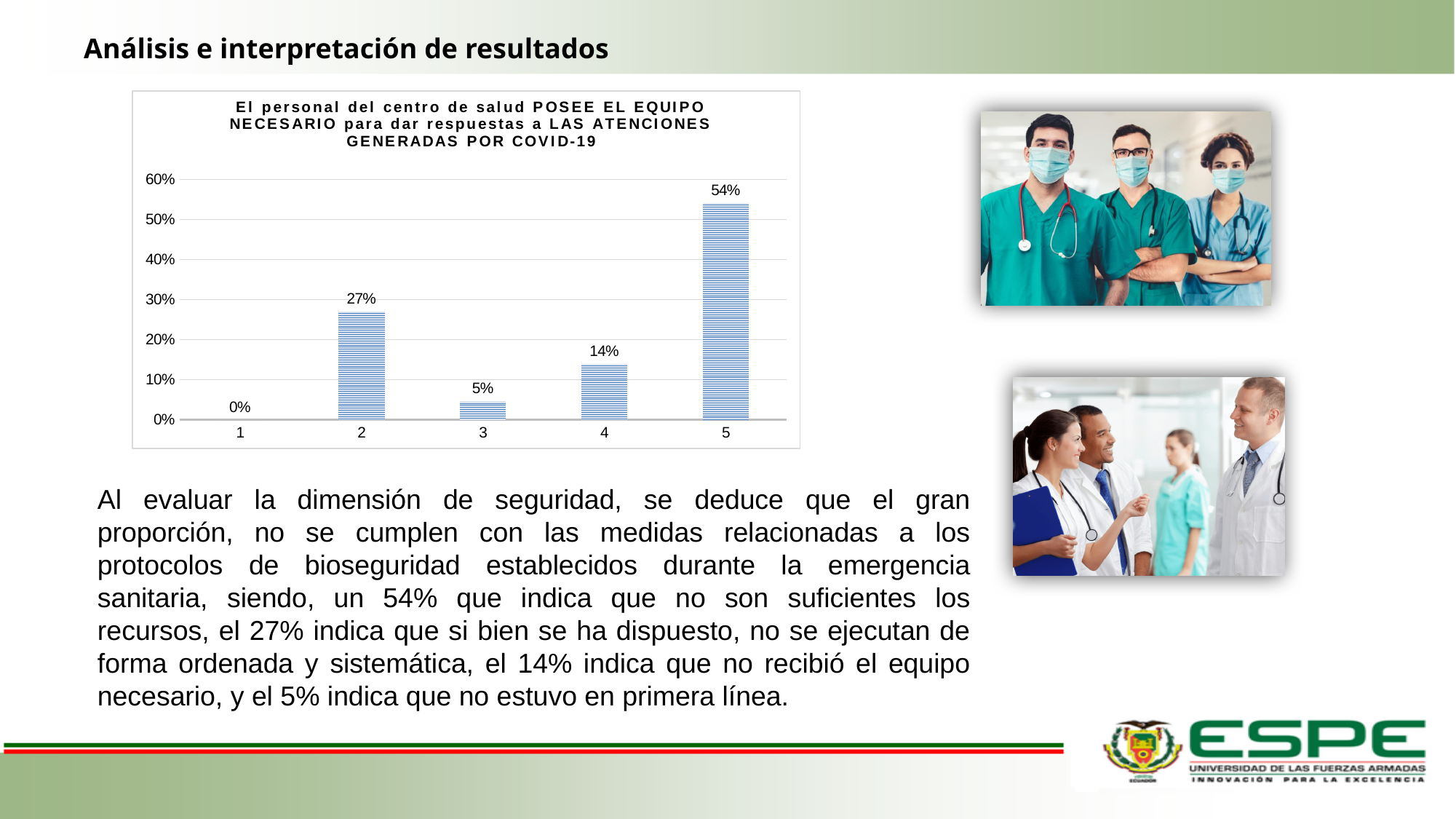
What is the value for category 1? 0% How many categories are shown on the x axis? 5 Is the value for category 5 greater or less than 50%? greater What is the difference between the values for category 5 and category 2? 27% Which category has the lowest value? 1 What is the value for category 3? 5% Which category has the highest value? 5 What is the value for category 5? 54% Which is larger, the value for category 4 or the value for category 3? 4 What kind of chart is shown on the slide? bar chart What is the value for category 2? 27% What is the difference between the values for category 4 and category 3? 9%